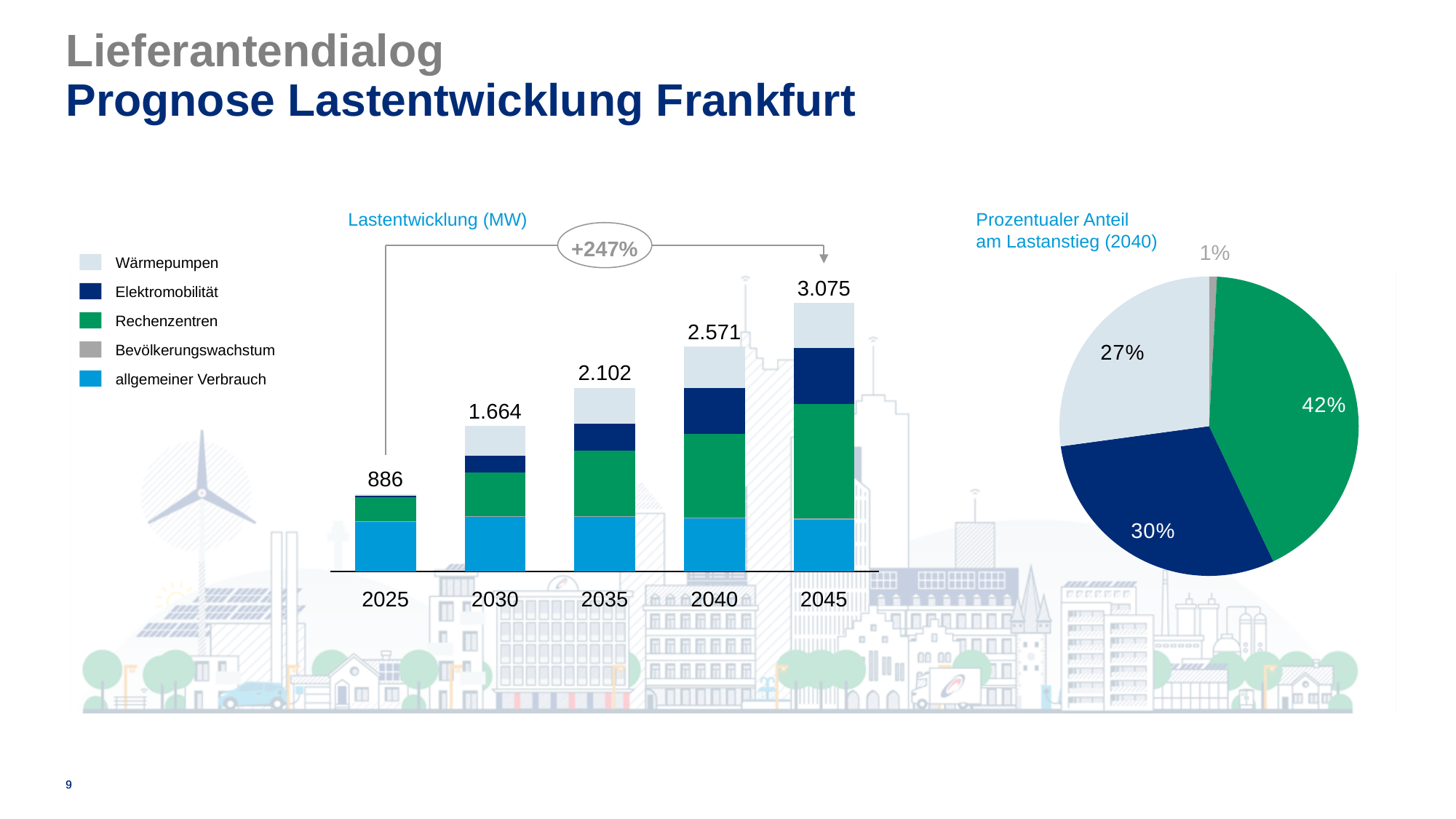
In the Lastentwicklung (MW) chart, which year has the highest total? 2045 In the Lastentwicklung (MW) chart, which year has the lowest total? 2025 How many series does the legend of the Lastentwicklung (MW) chart list? 5 What kind of chart is the Lastentwicklung (MW) chart? stacked bar chart In the Lastentwicklung (MW) chart, what is the total value shown for 2035? 2.102 How many years are shown on the x axis of the Lastentwicklung (MW) chart? 5 In the pie chart Prozentualer Anteil am Lastanstieg (2040), what share does the green slice (Rechenzentren) have? 42% In the Lastentwicklung (MW) chart, what is the difference between the totals for 2040 and 2030? 907 In the Lastentwicklung (MW) chart, do the totals rise or fall from 2025 to 2045? rise In the Lastentwicklung (MW) chart, what is the total value shown for 2045? 3.075 In the pie chart Prozentualer Anteil am Lastanstieg (2040), which is larger: the dark blue slice (Elektromobilität) or the light slice (Wärmepumpen)? Elektromobilität (30%) In the Lastentwicklung (MW) chart, what is the total value shown for 2025? 886